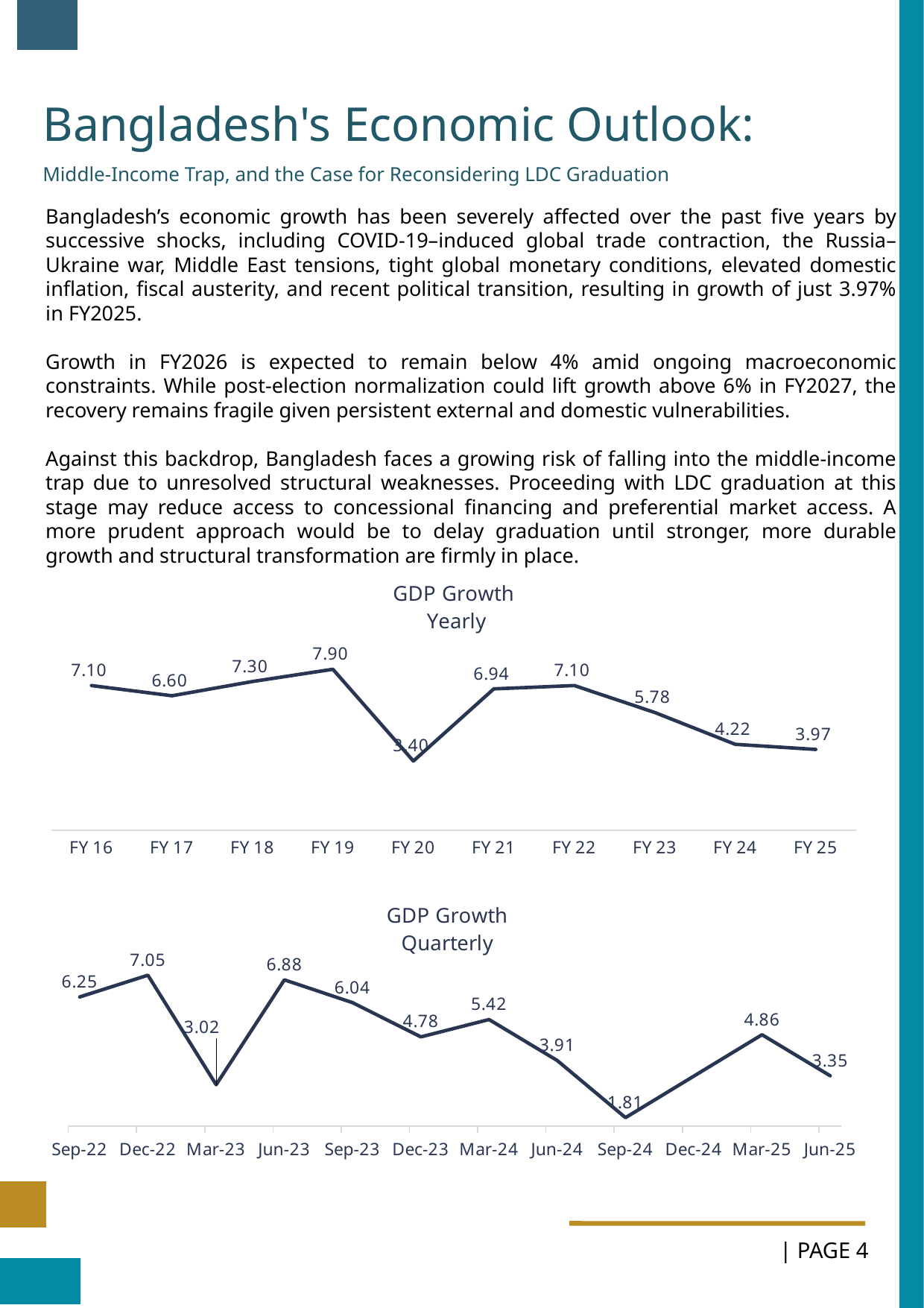
In the GDP Growth Quarterly chart, what is the value for Dec-22? 7.05 In the GDP Growth Yearly chart, what is the value for FY 19? 7.90 In the GDP Growth Yearly chart, what is the difference between the values for FY 22 and FY 23? 1.32 In the GDP Growth Quarterly chart, what is the value for Sep-24? 1.81 In the GDP Growth Yearly chart, which fiscal year has the highest value? FY 19 In the GDP Growth Quarterly chart, which is larger, the value for Mar-25 or the value for Jun-25? Mar-25 In the GDP Growth Quarterly chart, what is the difference between the values for Jun-23 and Sep-23? 0.84 In the GDP Growth Yearly chart, what is the value for FY 25? 3.97 In the GDP Growth Quarterly chart, which quarter has the highest value? Dec-22 What type of chart is the GDP Growth Quarterly chart? Line chart In the GDP Growth Yearly chart, how many fiscal years are shown on the x axis? 10 In the GDP Growth Yearly chart, which fiscal year has the lowest value? FY 20